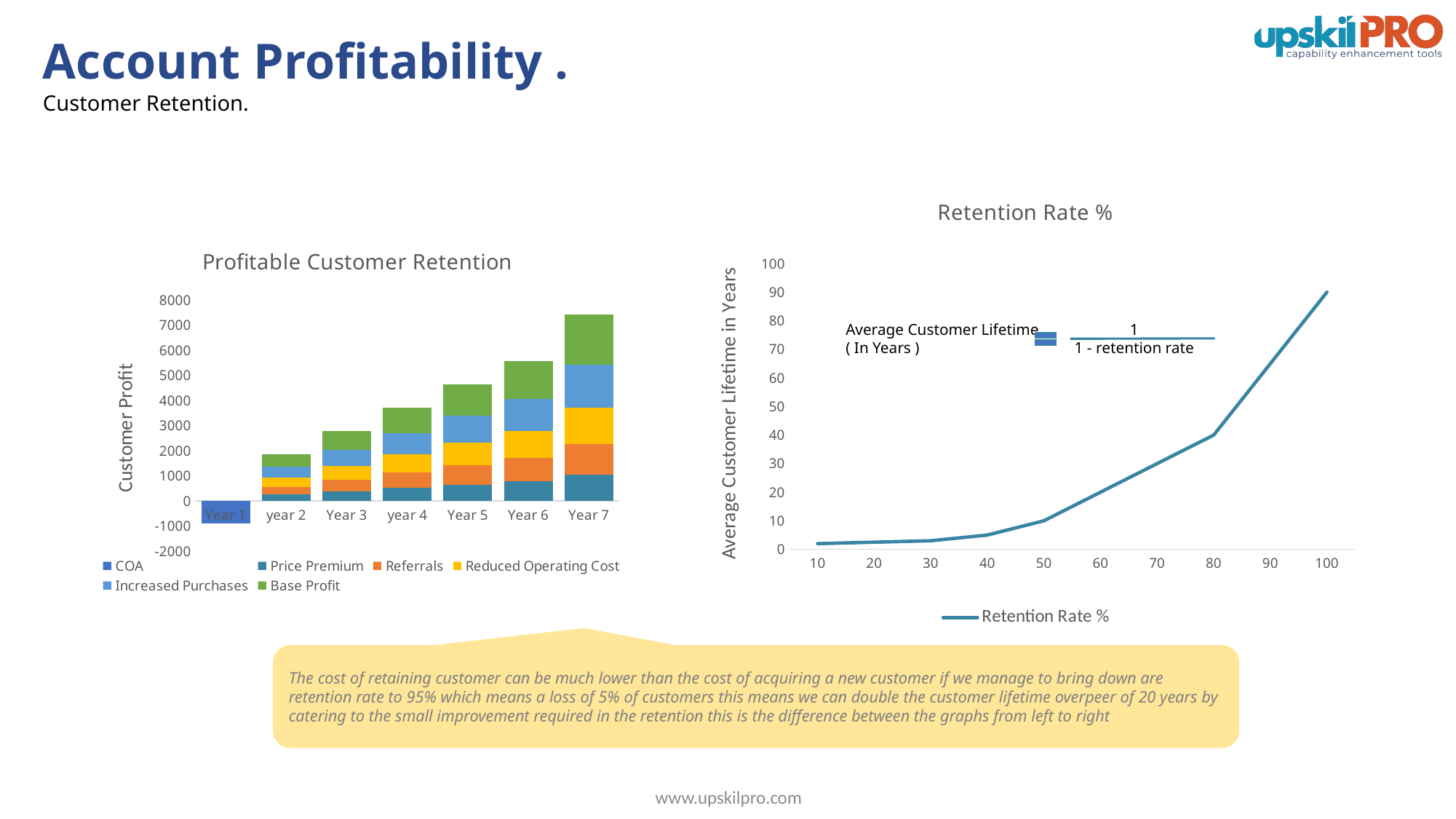
In the "Profitable Customer Retention" chart, is the total for year 2 greater or less than 2000? less In the "Profitable Customer Retention" chart, which year has the lowest customer profit? Year 1 In the "Profitable Customer Retention" chart, is the total for Year 7 greater or less than 7000? greater In the "Profitable Customer Retention" chart, which series is the only one plotted for Year 1? COA In the "Retention Rate %" chart, is the value at a retention rate of 50 greater or less than 20? less What type of chart is the "Retention Rate %" chart? Line chart In the "Retention Rate %" chart, does the average customer lifetime rise or fall as the retention rate increases along the x axis? Rises How many series does the legend of the "Profitable Customer Retention" chart list? 6 What type of chart is the "Profitable Customer Retention" chart? Stacked bar chart In the "Profitable Customer Retention" chart, which year has the highest total customer profit? Year 7 How many year categories are shown on the x axis of the "Profitable Customer Retention" chart? 7